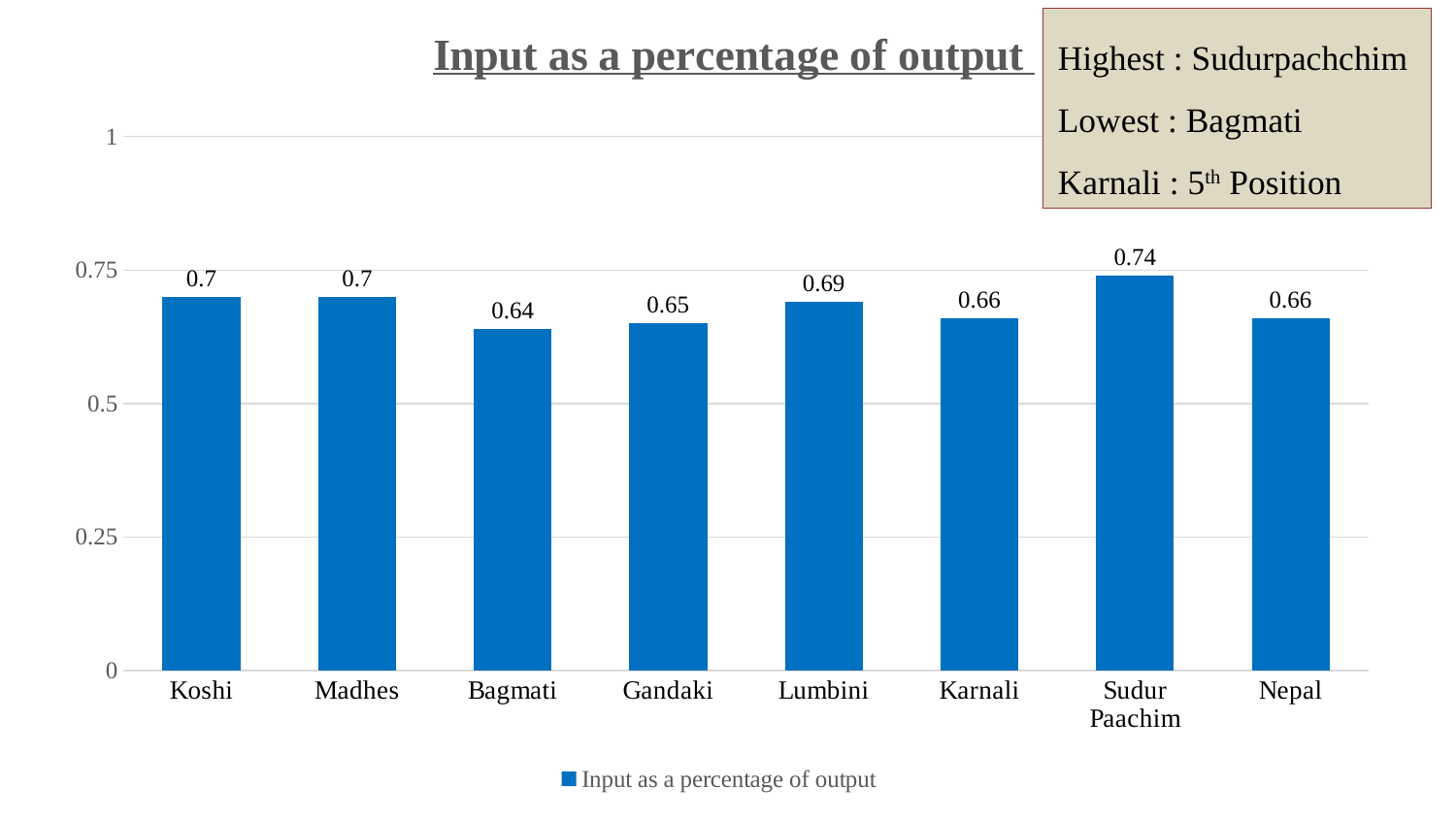
What is the value for Bagmati? 0.64 Which is larger, the value for Lumbini or the value for Gandaki? Lumbini Which category has the highest value? Sudur Paachim How many series does the legend list? 1 What is the value for Nepal? 0.66 What is the value for Sudur Paachim? 0.74 What is the difference between the values for Sudur Paachim and Bagmati? 0.1 What is the title of the chart? Input as a percentage of output Is the value for Koshi greater or less than 0.5? greater How many categories are shown on the x axis? 8 Which category has the lowest value? Bagmati What kind of chart is shown? bar chart